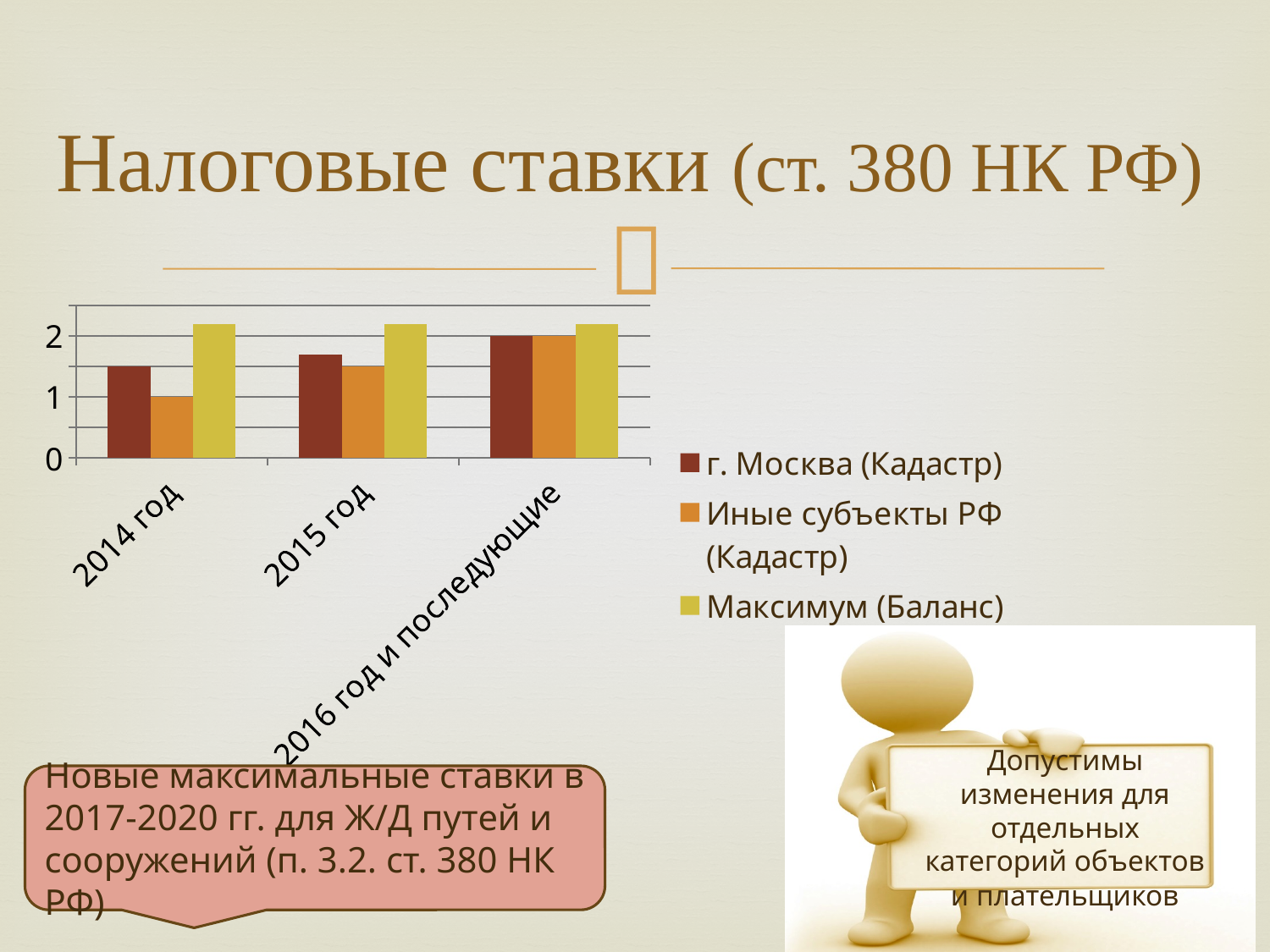
What is the value for г. Москва (Кадастр) in 2016 год и последующие? 2 What kind of chart is shown on the slide? bar chart How many series does the chart legend list? 3 Is the value for Максимум (Баланс) in 2014 год greater or less than 2? greater Is the value for г. Москва (Кадастр) in 2014 год greater or less than 1? greater Is the value for г. Москва (Кадастр) in 2015 год greater or less than 2? less Does the value for Иные субъекты РФ (Кадастр) rise or fall from 2014 год to 2016 год и последующие? rise What is the value for Иные субъекты РФ (Кадастр) in 2014 год? 1 Which series has the highest value in 2014 год? Максимум (Баланс) Which series is shown in yellow in the chart legend? Максимум (Баланс) How many categories are shown on the x axis of the chart? 3 Which series has the lowest value in 2015 год? Иные субъекты РФ (Кадастр)